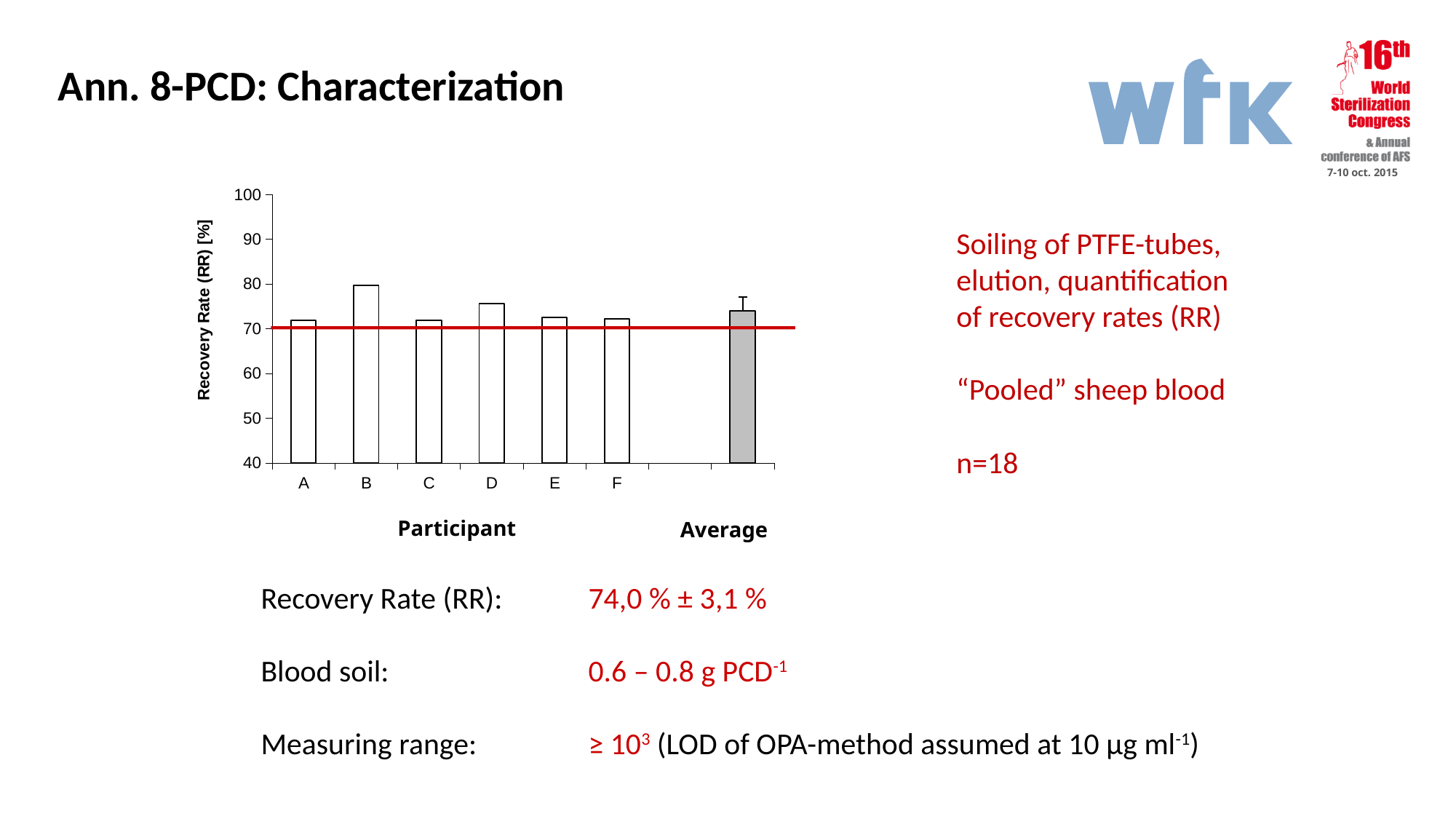
Which participant has the highest recovery rate? B What kind of chart is shown on the slide? bar chart Is the recovery rate for participant B greater or less than 90? less Is the recovery rate for participant B greater or less than 70? greater Is the recovery rate for participant A greater or less than 80? less Which has the larger recovery rate, participant D or participant C? D Which has the larger recovery rate, participant B or participant A? B What is the label of the y axis of the chart? Recovery Rate (RR) [%] How many participants are shown on the x axis of the chart? 6 How many bars are plotted in the chart in total, including the Average bar? 7 At what value on the y axis is the horizontal red line drawn? 70